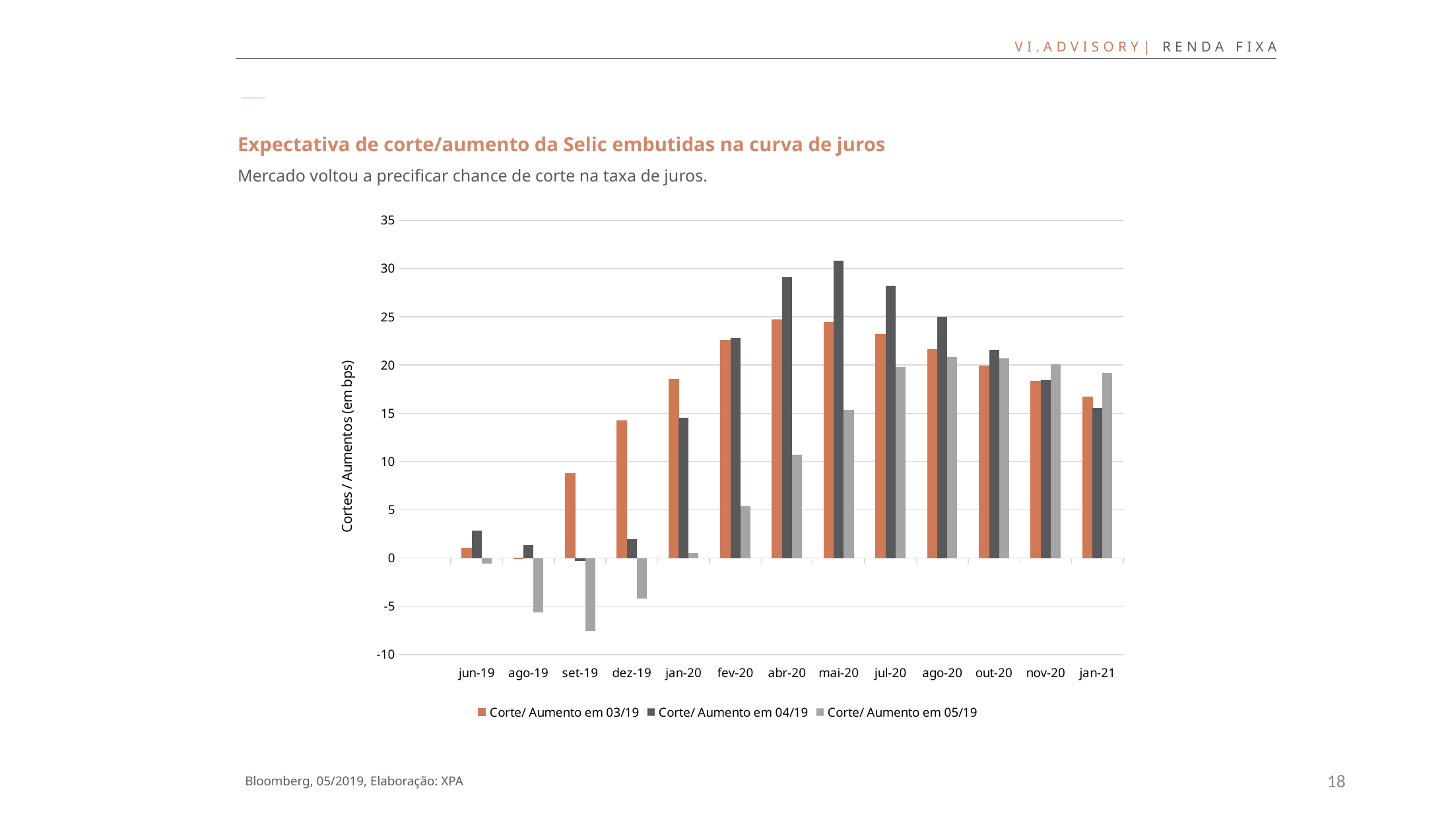
Do the values for 'Corte/ Aumento em 03/19' rise or fall from mai-20 to jan-21? fall How many series does the legend list? 3 Is the value for 'Corte/ Aumento em 03/19' at jan-20 greater or less than 15? greater At abr-20, which series has the larger value: 'Corte/ Aumento em 04/19' or 'Corte/ Aumento em 05/19'? Corte/ Aumento em 04/19 For the series 'Corte/ Aumento em 04/19', which category has the highest value? mai-20 For the series 'Corte/ Aumento em 05/19', which category has the lowest value? set-19 What kind of chart is shown on the slide? bar chart Is the value for 'Corte/ Aumento em 05/19' at set-19 greater or less than -5? less At jan-21, which series has the larger value: 'Corte/ Aumento em 04/19' or 'Corte/ Aumento em 05/19'? Corte/ Aumento em 05/19 How many categories are shown on the x axis? 13 What is the label of the y axis? Cortes / Aumentos (em bps) Is the value for 'Corte/ Aumento em 04/19' at mai-20 greater or less than 30? greater